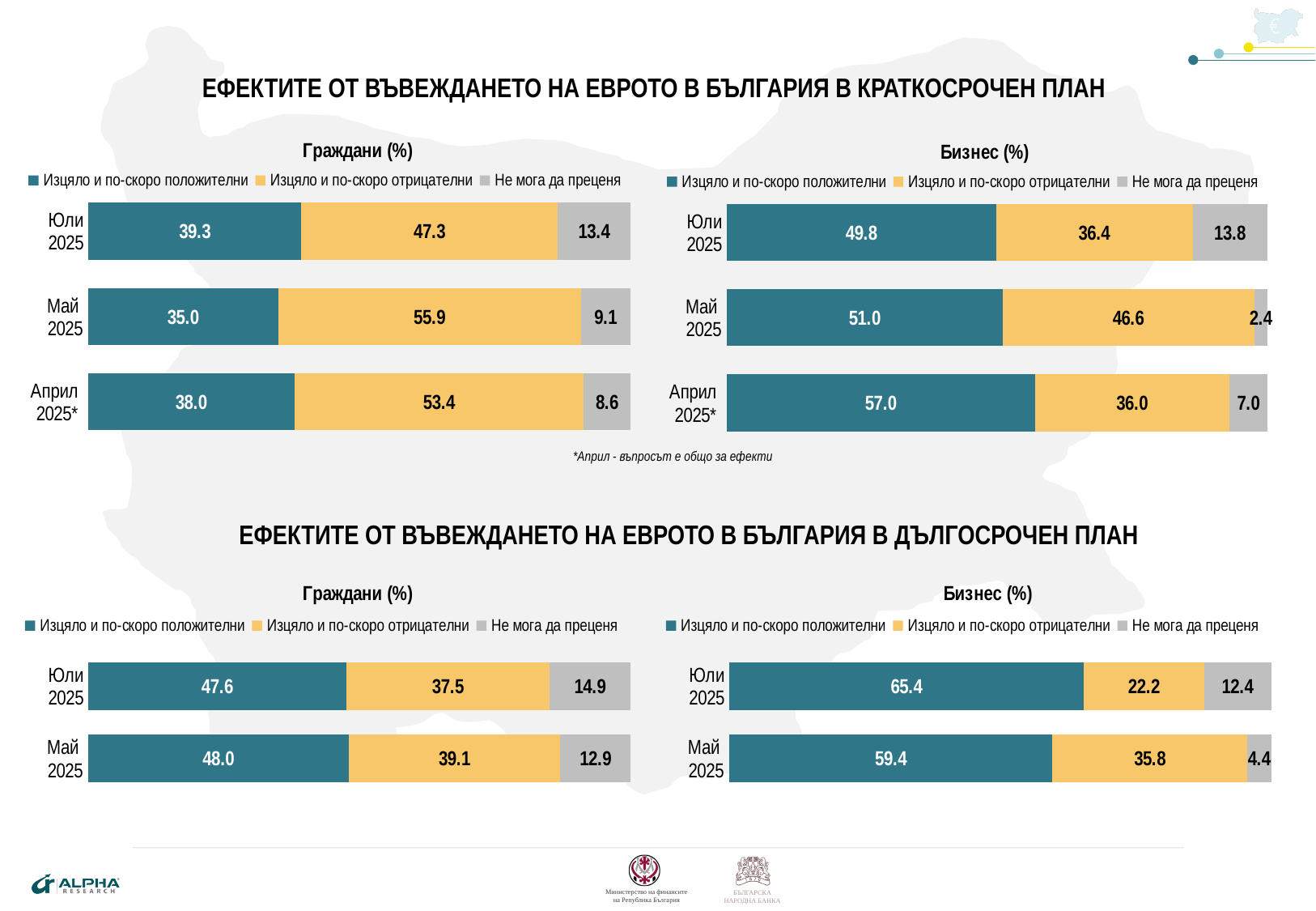
In the short-term plan chart for Граждани (%) (top left), what is the total of the Май 2025 bar? 100.0 What kind of chart is the long-term plan chart for Граждани (%) (bottom left)? Stacked bar chart In the short-term plan chart for Бизнес (%) (top right), what colour represents 'Не мога да преценя'? Grey In the short-term plan chart for Бизнес (%) (top right), what is the value for 'Изцяло и по-скоро отрицателни' in Май 2025? 46.6 In the short-term plan chart for Граждани (%) (top left), what is the value for 'Изцяло и по-скоро положителни' in Юли 2025? 39.3 In the long-term plan chart for Граждани (%) (bottom left), which is larger: 'Изцяло и по-скоро отрицателни' in Юли 2025 or in Май 2025? Май 2025 How many periods are shown in the short-term plan chart for Граждани (%) (top left)? 3 In the long-term plan chart for Бизнес (%) (bottom right), what is the value for 'Не мога да преценя' in Юли 2025? 12.4 How many series does the legend list in the long-term plan chart for Бизнес (%) (bottom right)? 3 In the short-term plan chart for Бизнес (%) (top right), which period has the highest value for 'Изцяло и по-скоро положителни'? Април 2025* In the long-term plan chart for Бизнес (%) (bottom right), what is the difference between the 'Изцяло и по-скоро положителни' values for Юли 2025 and Май 2025? 6.0 In the short-term plan chart for Граждани (%) (top left), which period has the lowest value for 'Не мога да преценя'? Април 2025*